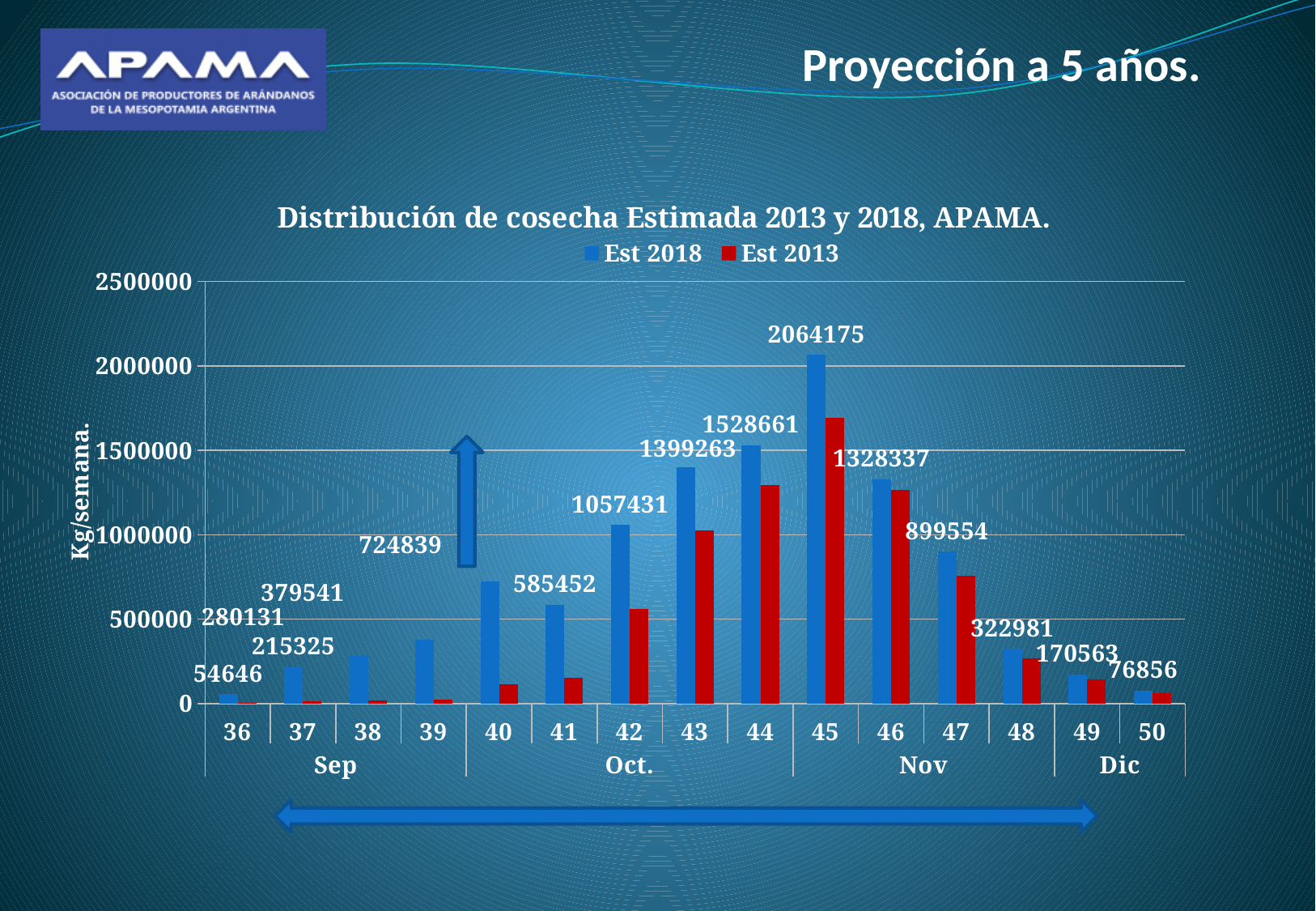
How many series does the legend list? 2 Which week has the lowest Est 2018 value? 36 What is the Est 2018 value for week 45? 2064175 What is the difference between the Est 2018 values for week 45 and week 44? 535514 What is the difference between the Est 2018 values for week 46 and week 47? 428783 What kind of chart is shown? bar chart Which week has the highest Est 2018 value? 45 What is the Est 2018 value for week 42? 1057431 Which week has the larger Est 2018 value, week 40 or week 41? 40 What is the label on the vertical axis? Kg/semana. How many weeks are shown on the x axis? 15 Is the Est 2013 value for week 45 greater or less than 1500000? greater